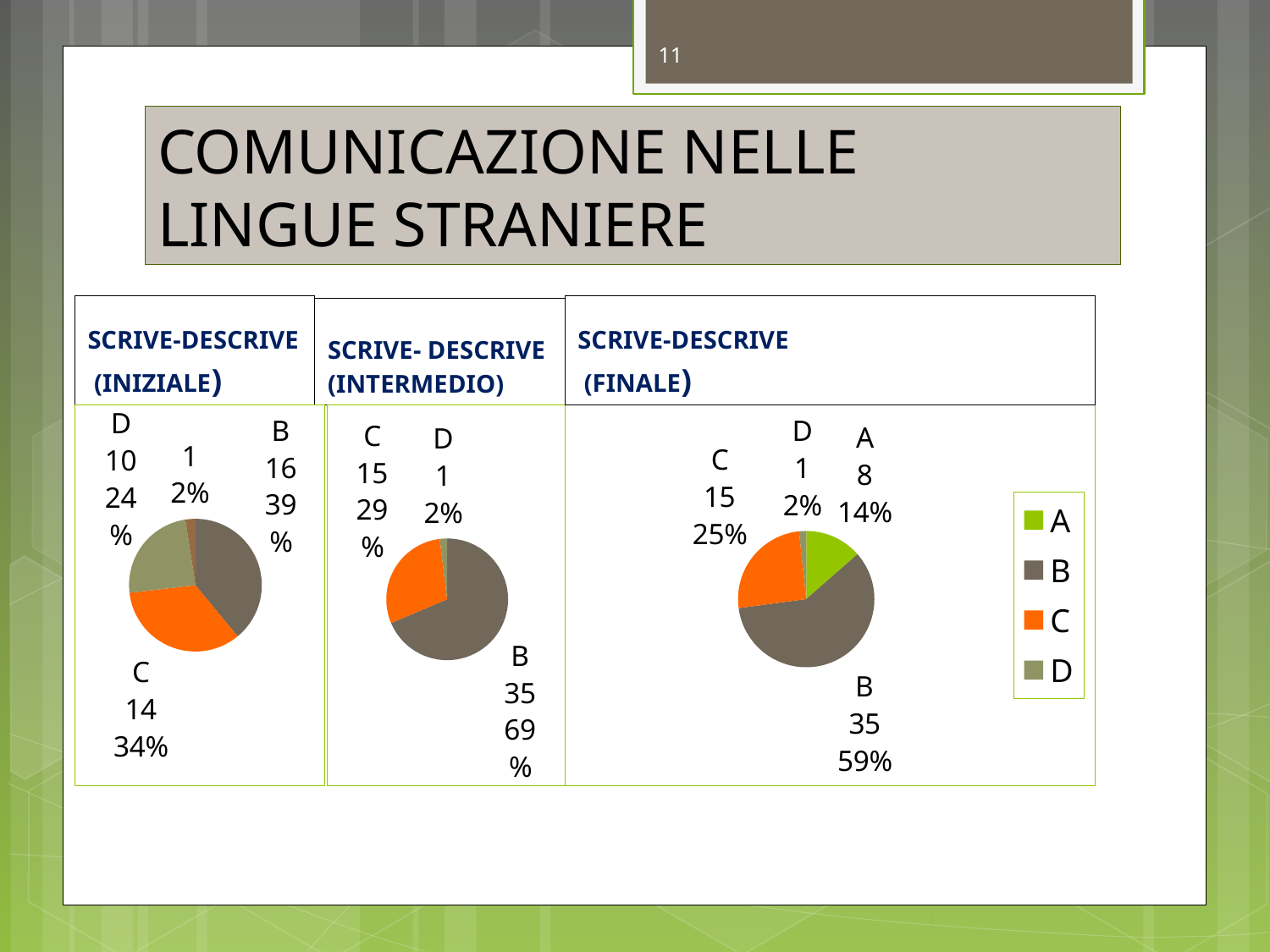
In the SCRIVE-DESCRIVE (INTERMEDIO) pie chart, what count is shown for category B? 35 In the SCRIVE-DESCRIVE (INIZIALE) pie chart, what count is shown for category B? 16 In the SCRIVE-DESCRIVE (FINALE) pie chart, what is the difference between the counts for B and C? 20 How many entries does the legend next to the SCRIVE-DESCRIVE (FINALE) chart list? 4 In the SCRIVE-DESCRIVE (INIZIALE) pie chart, which category has the largest slice? B In the SCRIVE-DESCRIVE (FINALE) pie chart, what count is shown for category C? 15 In the SCRIVE-DESCRIVE (INTERMEDIO) pie chart, what percentage share does category C have? 29% In the SCRIVE-DESCRIVE (INIZIALE) pie chart, what percentage share does category C have? 34% In the SCRIVE-DESCRIVE (FINALE) pie chart, which is larger, the slice for A or the slice for C? C In the SCRIVE-DESCRIVE (INTERMEDIO) pie chart, how many labelled categories are shown? 3 In the SCRIVE-DESCRIVE (FINALE) pie chart, what percentage share does category A have? 14% In the SCRIVE-DESCRIVE (INTERMEDIO) pie chart, which category has the smallest slice? D